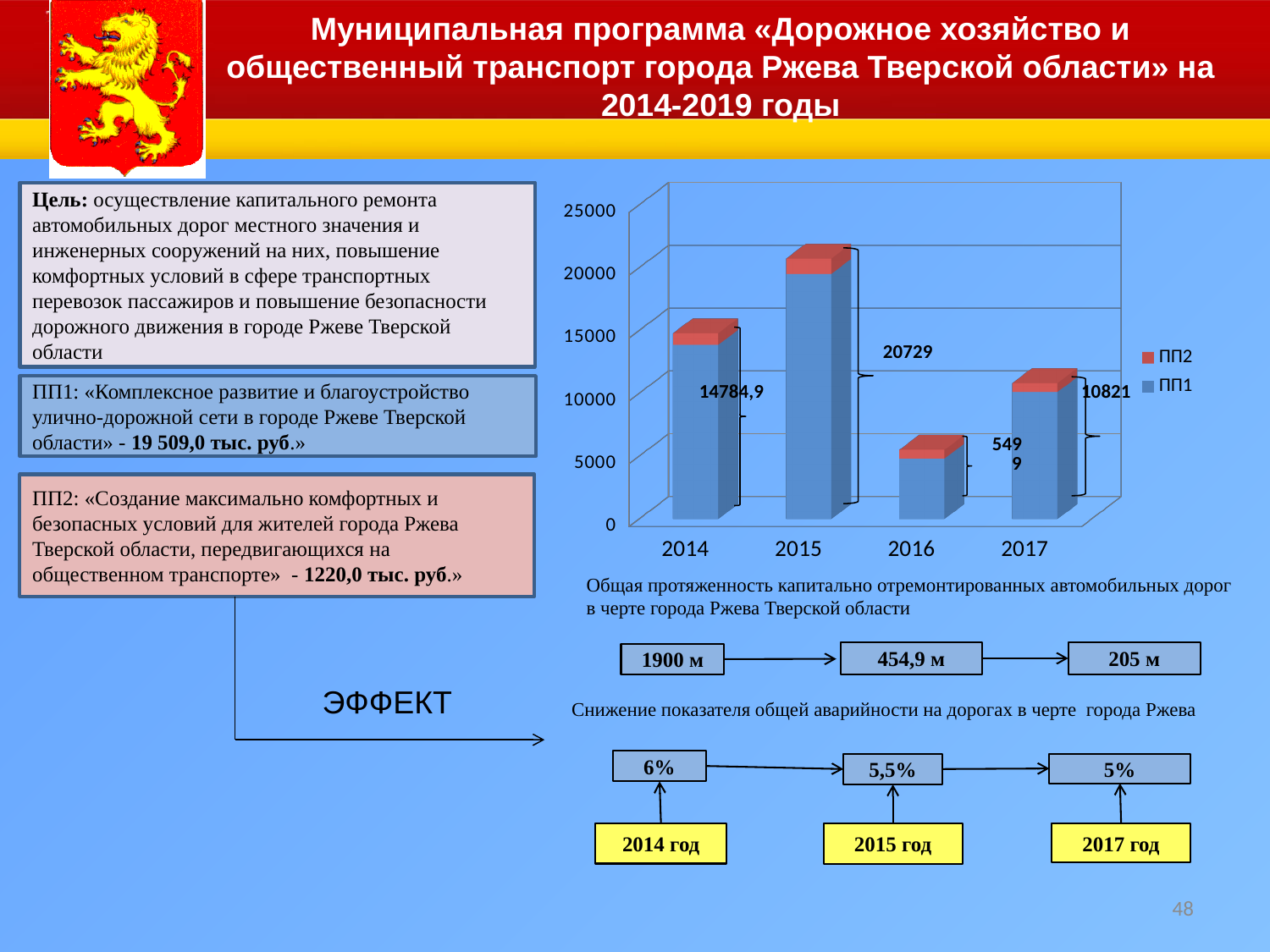
Which year has the shortest stacked bar in the chart? 2016 Which year has the tallest stacked bar in the chart? 2015 How many years are shown on the x axis of the chart? 4 What is the difference between the labelled totals for 2015 and 2016? 15230 How many series does the chart legend list? 2 Which bar is taller, 2014 or 2017? 2014 Which series is shown in red in the chart legend? ПП2 What is the total value labelled for the 2015 bar? 20729 What is the total value labelled for the 2014 bar? 14784,9 Is the total for 2016 greater or less than 10000? less What kind of chart is shown on the slide? bar chart What is the total value labelled for the 2017 bar? 10821